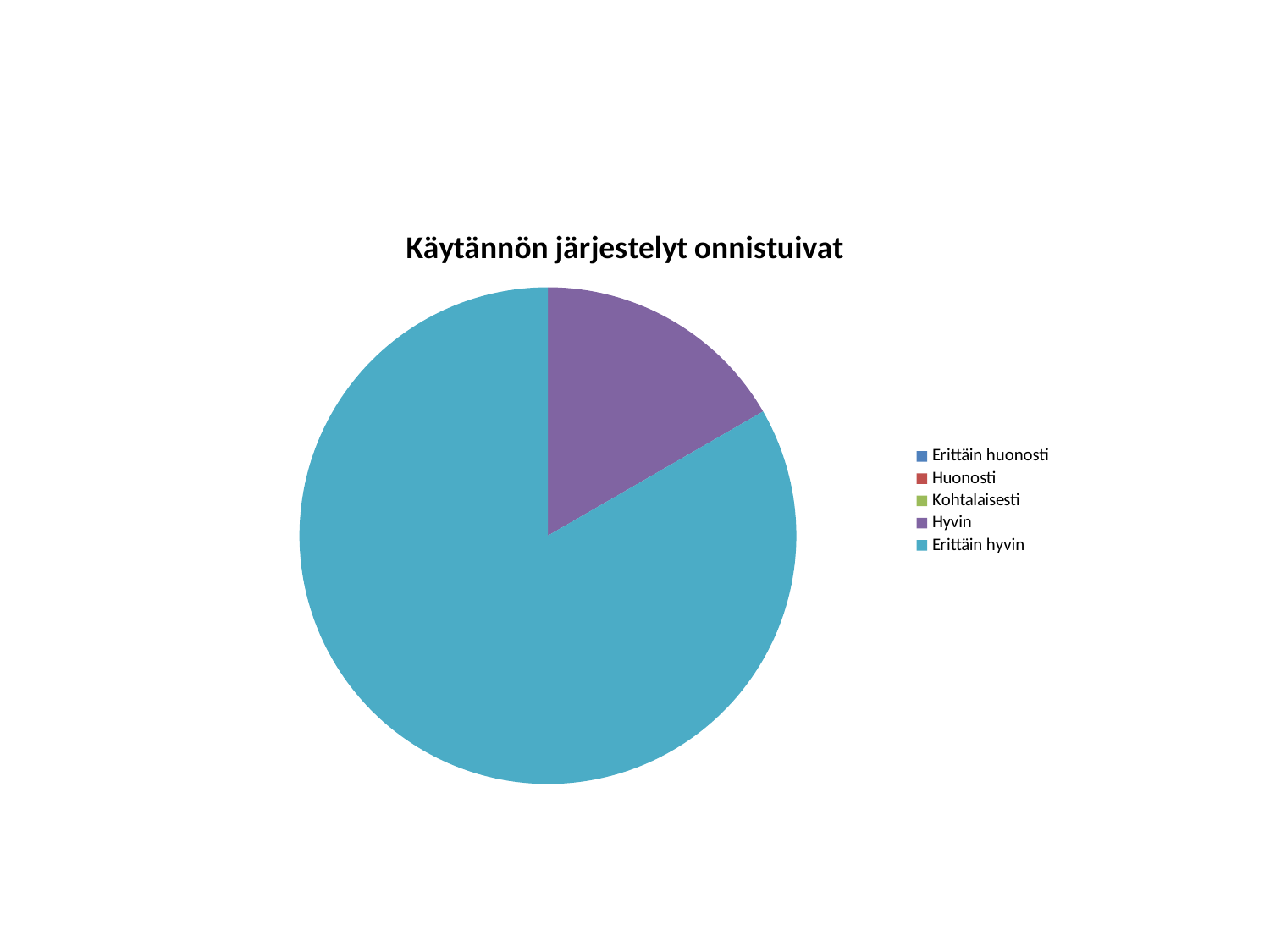
What is the title of the chart? Käytännön järjestelyt onnistuivat Does the slice for Erittäin hyvin cover more or less than half of the pie? more Which is larger, the slice for Hyvin or the slice for Erittäin hyvin? Erittäin hyvin How many entries does the legend list? 5 Which category has the largest slice of the pie? Erittäin hyvin Which of the two visible slices is the smaller one? Hyvin How many slices are visible in the pie? 2 Which legend entry is shown in purple? Hyvin What kind of chart is shown on the slide? pie chart